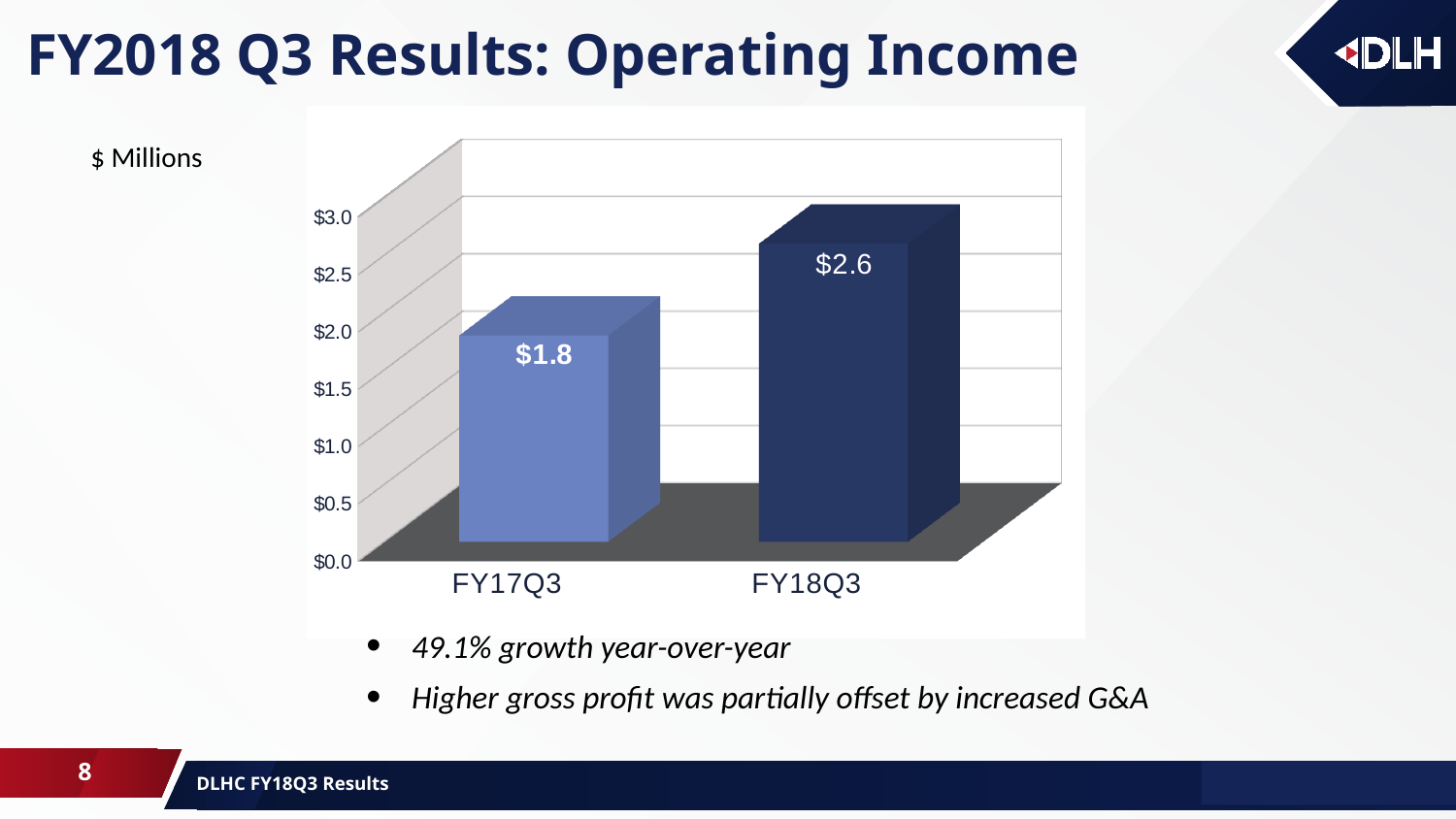
Is the value for FY18Q3 greater or less than $2.0? greater Is the value for FY17Q3 greater or less than $2.0? less Do the values rise or fall from FY17Q3 to FY18Q3? Rise Which quarter has the higher operating income, FY17Q3 or FY18Q3? FY18Q3 What is the difference between the FY18Q3 and FY17Q3 values? $0.8 What is the operating income value shown for FY18Q3? $2.6 Which category has the lowest value in the chart? FY17Q3 What unit is indicated for the values in the chart? $ Millions What kind of chart is shown on the slide? Bar chart How many categories are plotted in the chart? 2 Which category has the highest value in the chart? FY18Q3 What is the operating income value shown for FY17Q3? $1.8